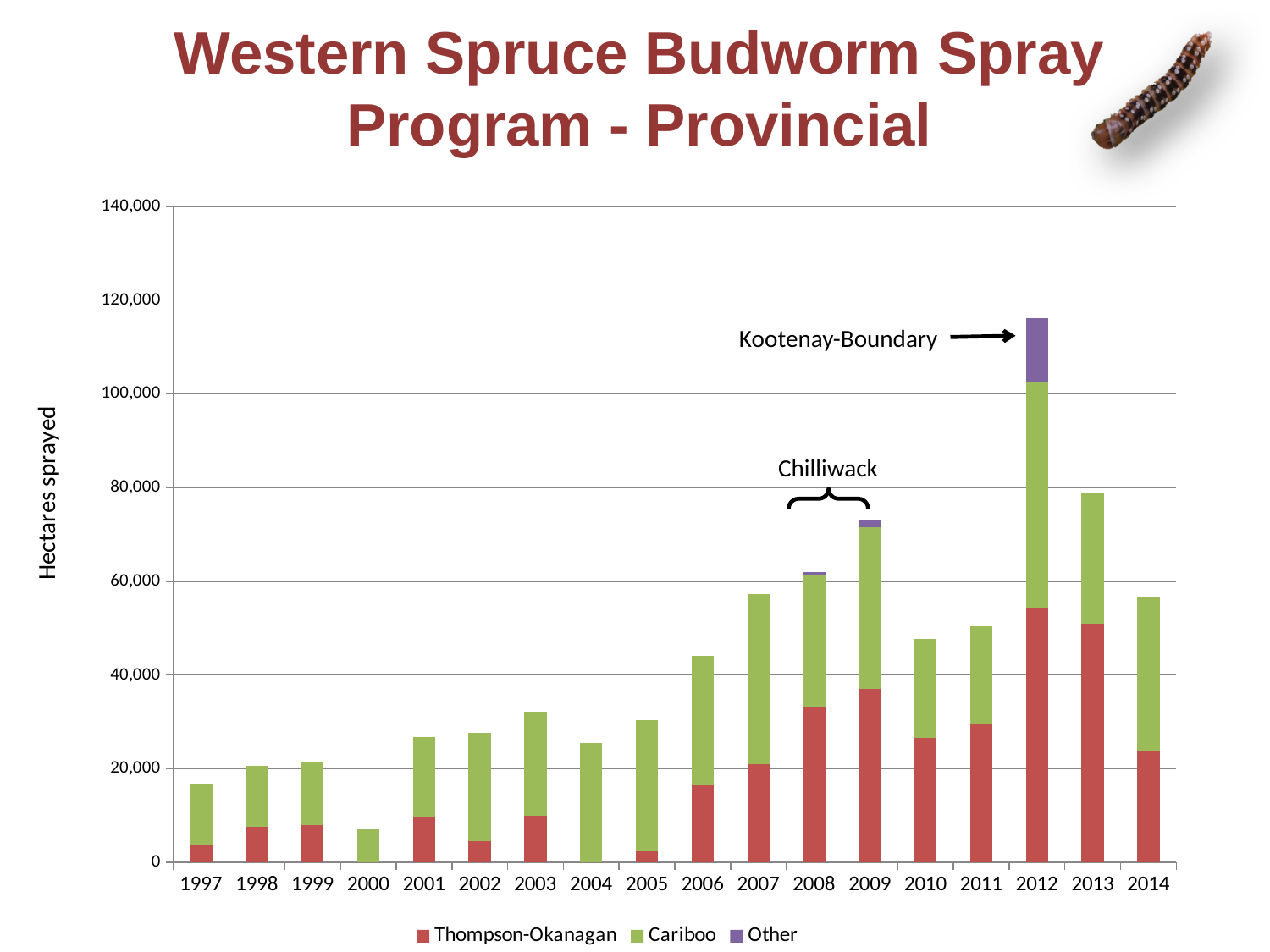
How many series does the legend list? 3 Is the total for 2012 greater or less than 100,000? greater Which region does the arrow annotation point to on the 2012 bar? Kootenay-Boundary Do the total hectares sprayed rise or fall from 2004 to 2009? rise How many years are shown on the x axis? 18 Which year has a larger total, 2008 or 2010? 2008 Is the total for 2000 greater or less than 20,000? less Is the total for 2009 greater or less than 60,000? greater Which year has the highest total hectares sprayed? 2012 What type of chart is shown on the slide? Stacked bar chart Which year has the lowest total hectares sprayed? 2000 What is the label on the y axis? Hectares sprayed